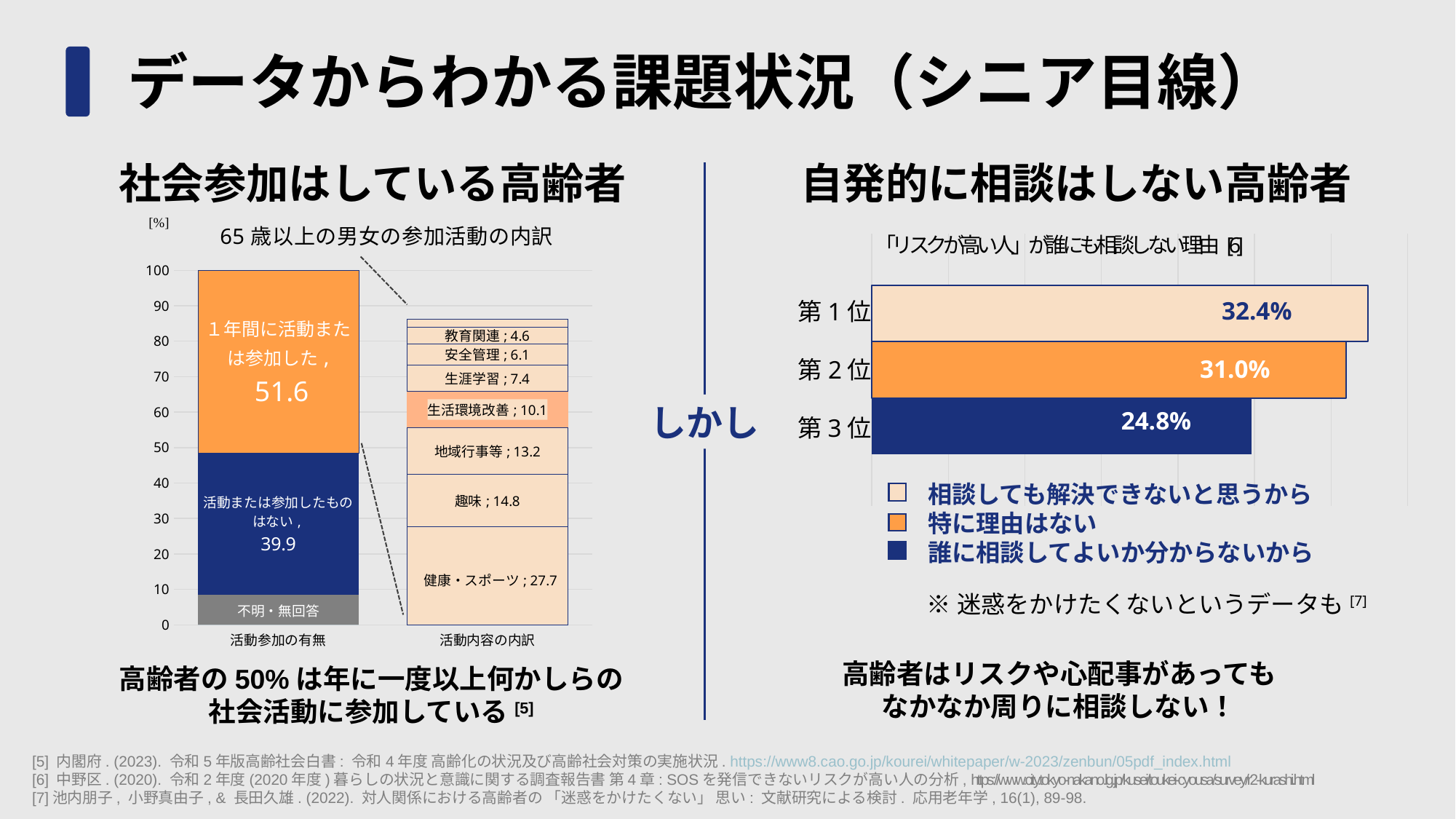
In the right chart (「リスクが高い人」が誰にも相談しない理由), which legend entry corresponds to the dark blue bar? 誰に相談してよいか分からないから In the right chart (「リスクが高い人」が誰にも相談しない理由), how many bars are plotted? 3 In the right chart (「リスクが高い人」が誰にも相談しない理由), what is the value for 第1位? 32.4% In the left chart (65歳以上の男女の参加活動の内訳), what is the value for 健康・スポーツ in the 活動内容の内訳 breakdown? 27.7 What kind of chart is the left chart (65歳以上の男女の参加活動の内訳)? Stacked bar chart In the right chart (「リスクが高い人」が誰にも相談しない理由), what is the difference between 第1位 and 第3位? 7.6% In the left chart (65歳以上の男女の参加活動の内訳), what is the value for 「活動または参加したものはない」? 39.9 In the right chart (「リスクが高い人」が誰にも相談しない理由), how many entries does the legend list? 3 In the left chart (65歳以上の男女の参加活動の内訳), what is the value for 「1年間に活動または参加した」? 51.6 In the right chart (「リスクが高い人」が誰にも相談しない理由), what is the value for 第3位? 24.8% In the left chart (65歳以上の男女の参加活動の内訳), which is larger, 趣味 or 地域行事等? 趣味